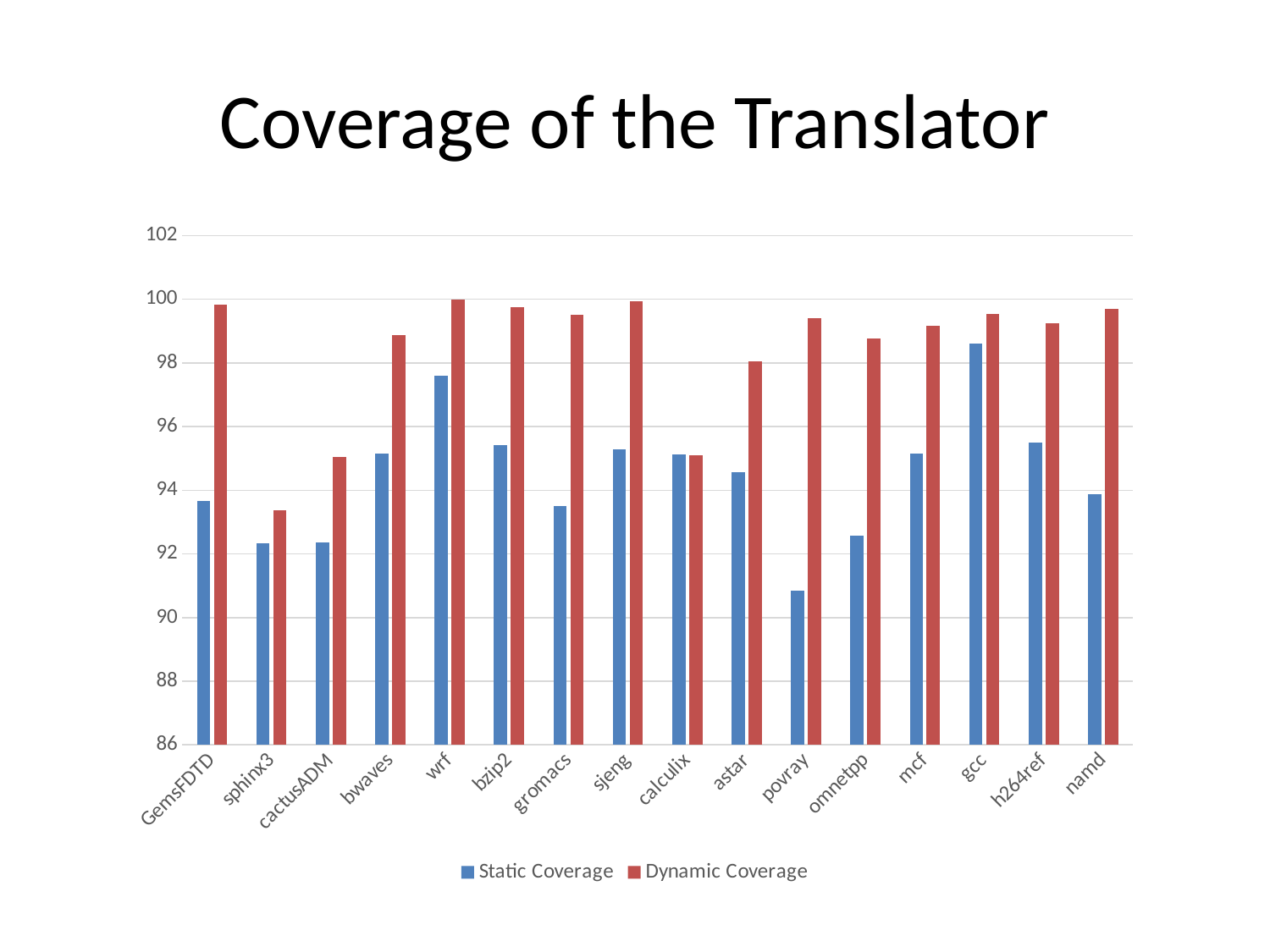
Which is larger, the Static Coverage for wrf or the Static Coverage for gcc? gcc Is the Dynamic Coverage value for sphinx3 greater or less than 94? less What kind of chart is shown on the slide? bar chart Which benchmark has the lowest Dynamic Coverage? sphinx3 Is the Static Coverage value for povray greater or less than 92? less Is the Dynamic Coverage value for GemsFDTD greater or less than 98? greater What is the title of the chart? Coverage of the Translator Which benchmark has the highest Static Coverage? gcc Which benchmark has the lowest Static Coverage? povray How many benchmark categories are shown on the x axis? 16 How many series does the legend list? 2